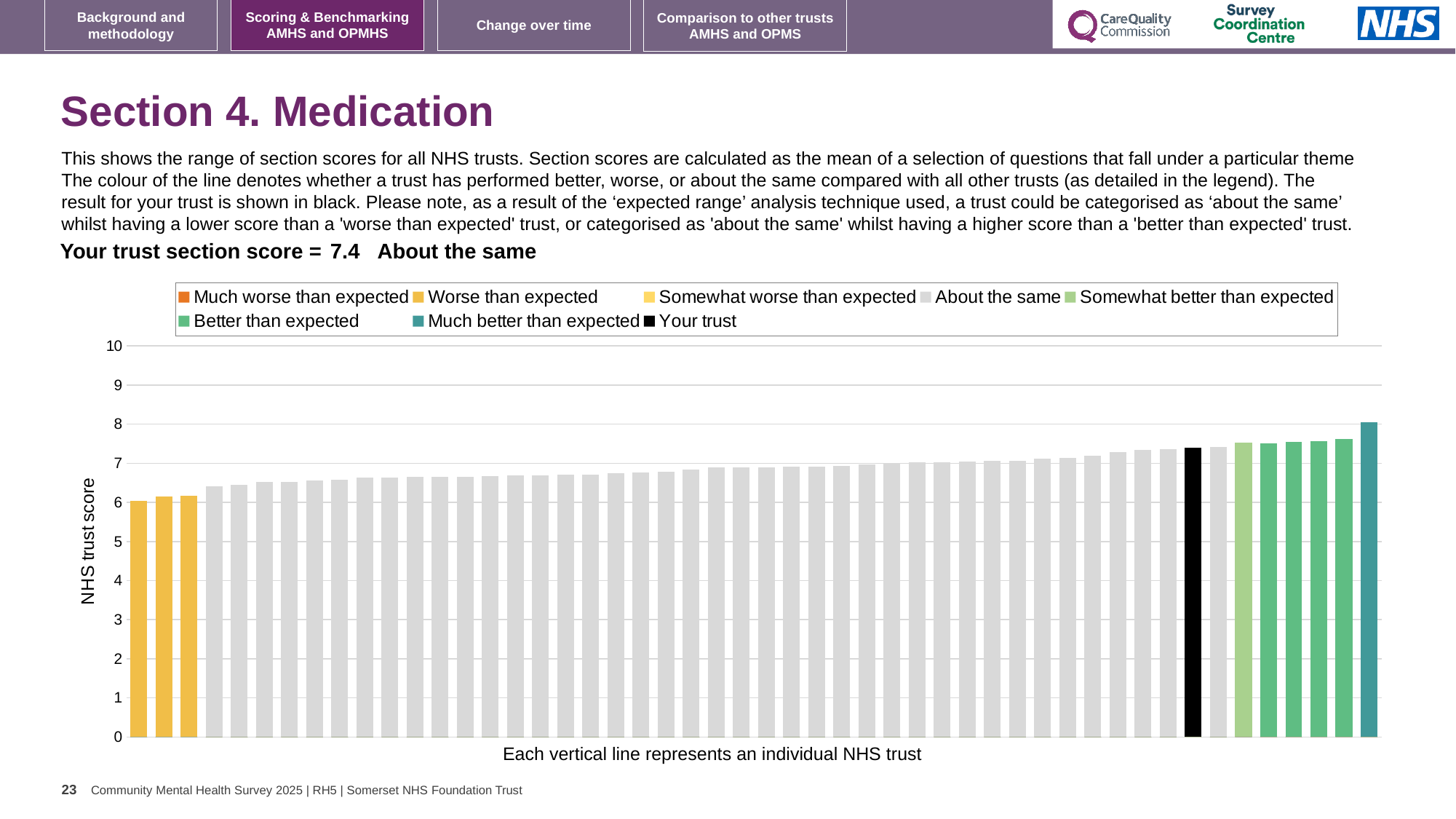
Do the bar values rise or fall from left to right along the x axis? rise Is the value of the leftmost bar greater or less than 7? less How many bars are coloured as 'Much better than expected'? 1 What is the section score for your trust shown on the slide? 7.4 What kind of chart is shown on the slide? bar chart Is the value of the black bar (your trust) greater or less than 7? greater Is the value of the rightmost bar greater or less than 7? greater What colour is used for the bar representing your trust? black How many entries does the chart legend list? 8 Which category is your trust's section score placed in? About the same What is the label on the vertical axis of the chart? NHS trust score How many bars are coloured as 'Worse than expected'? 3